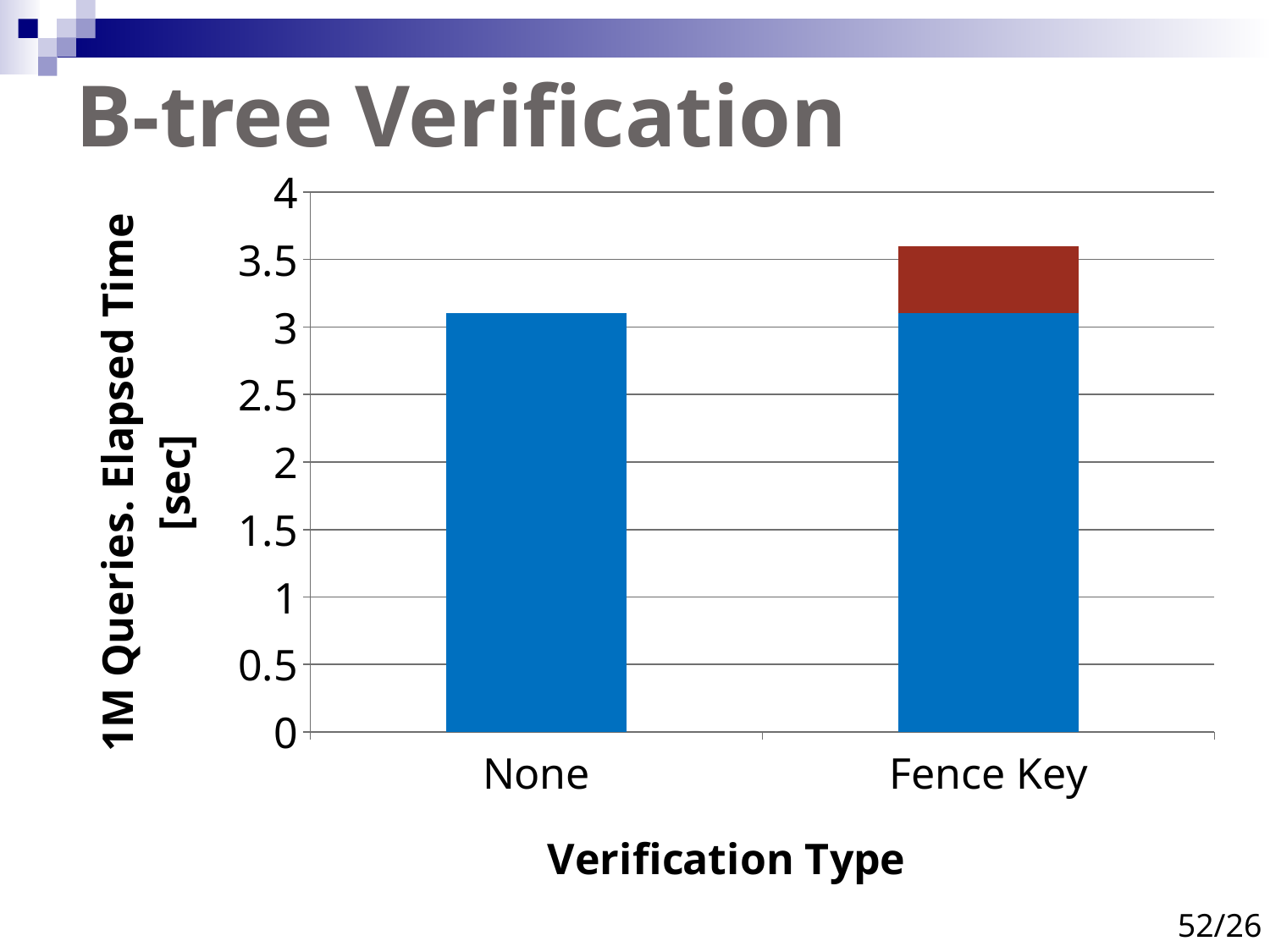
Which verification type has the taller bar? Fence Key What kind of chart is shown on the slide? bar chart Is the total value for Fence Key greater or less than 4? less What is the label of the x axis? Verification Type Is the value for None greater or less than 3? greater Which verification type has the shorter bar? None Which bar is taller, None or Fence Key? Fence Key Is the total value for Fence Key greater or less than 3? greater Do the bar heights rise or fall from None to Fence Key? rise What is the title of the slide containing the chart? B-tree Verification How many verification types are shown on the x axis? 2